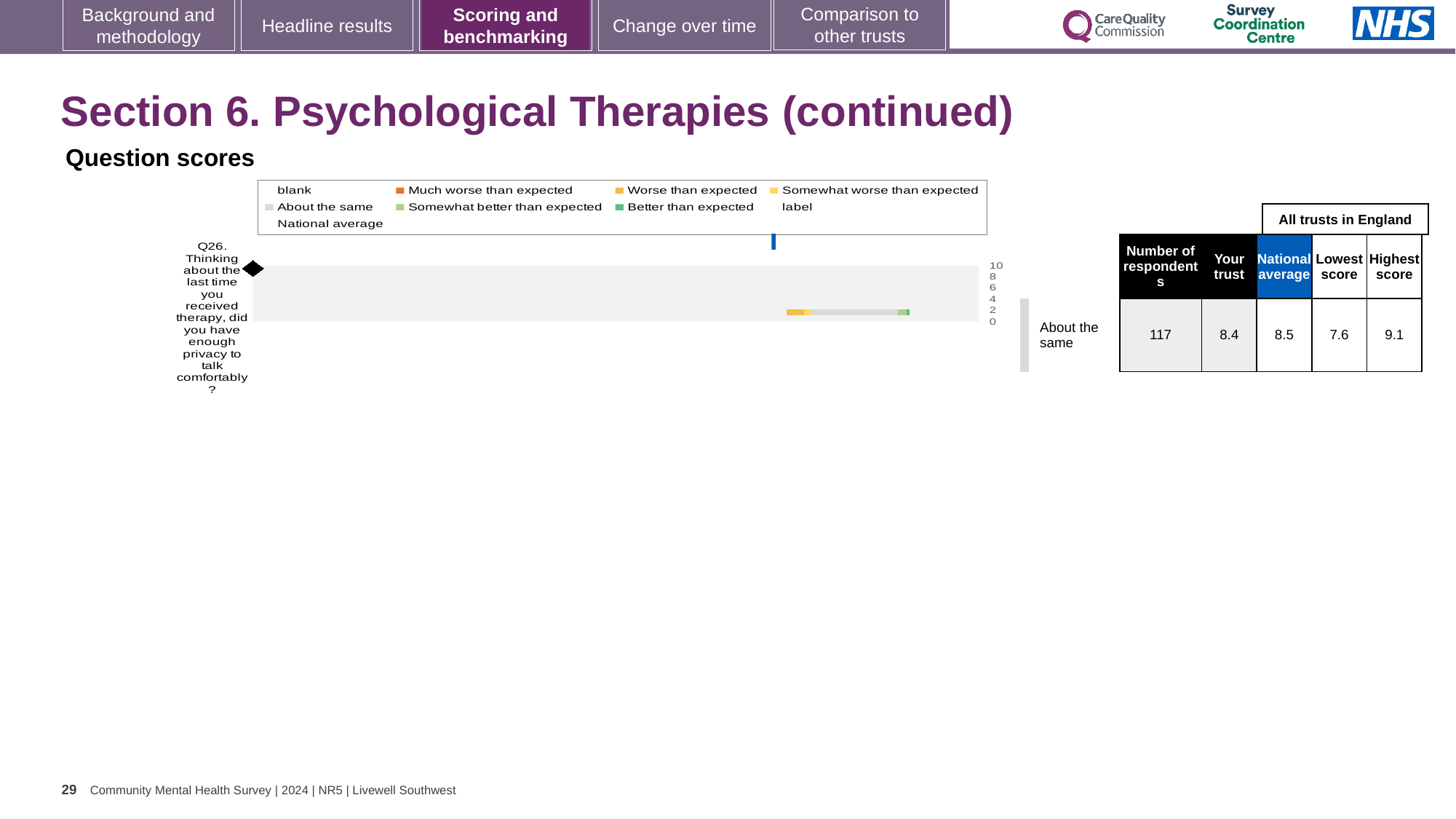
How many respondents answered Q26 according to the table next to the chart? 117 What is the maximum value shown on the chart's score axis? 10 What is the national average score for Q26 shown on the slide? 8.5 What is the lowest score among all trusts in England for Q26? 7.6 Which is larger for Q26: the trust's score or the national average? National average How many questions are plotted on the question scores chart? 1 What is the highest score among all trusts in England for Q26? 9.1 What is the 'Your trust' score for Q26 on the question scores chart? 8.4 What is the difference between the national average and the trust's score for Q26? 0.1 How is the trust's result for Q26 categorised relative to expectations? About the same What kind of chart is used to show the question scores? Bar chart What is the difference between the highest and lowest scores across all trusts in England for Q26? 1.5